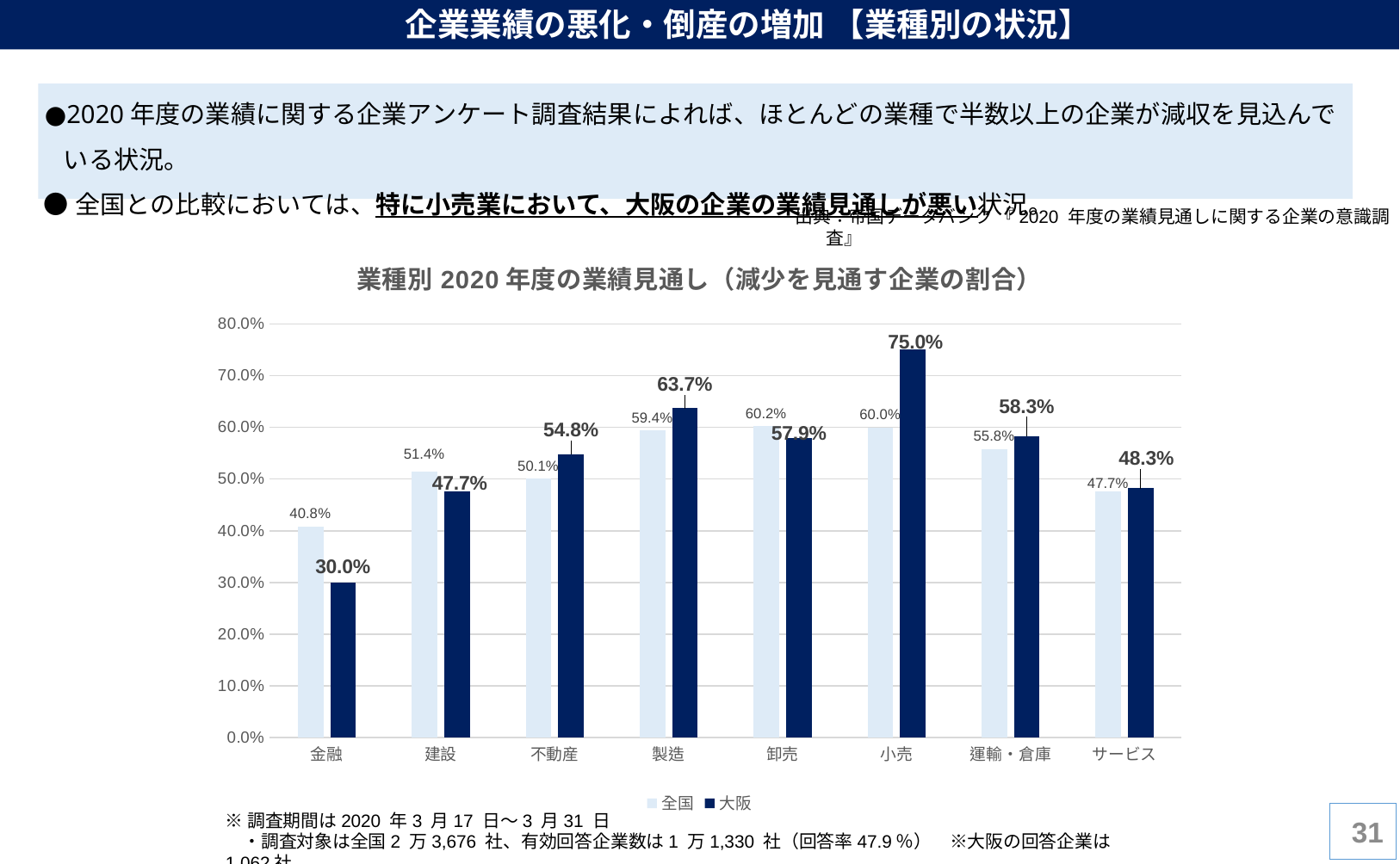
How many industry categories are shown on the x axis? 8 What is the value for 全国 in the 金融 category? 40.8% How many series does the legend list? 2 Is the 大阪 value for 製造 greater or less than 60.0%? greater What is the value for 大阪 in the 小売 category? 75.0% What is the difference between the 大阪 and 全国 values for 小売? 15.0% What is the title of the chart? 業種別 2020 年度の業績見通し（減少を見通す企業の割合） Which category has the highest 大阪 value? 小売 What is the value for 全国 in the 運輸・倉庫 category? 55.8% Which category has the lowest 大阪 value? 金融 What kind of chart is shown on the slide? bar chart Which is larger for 卸売, the 全国 value or the 大阪 value? 全国